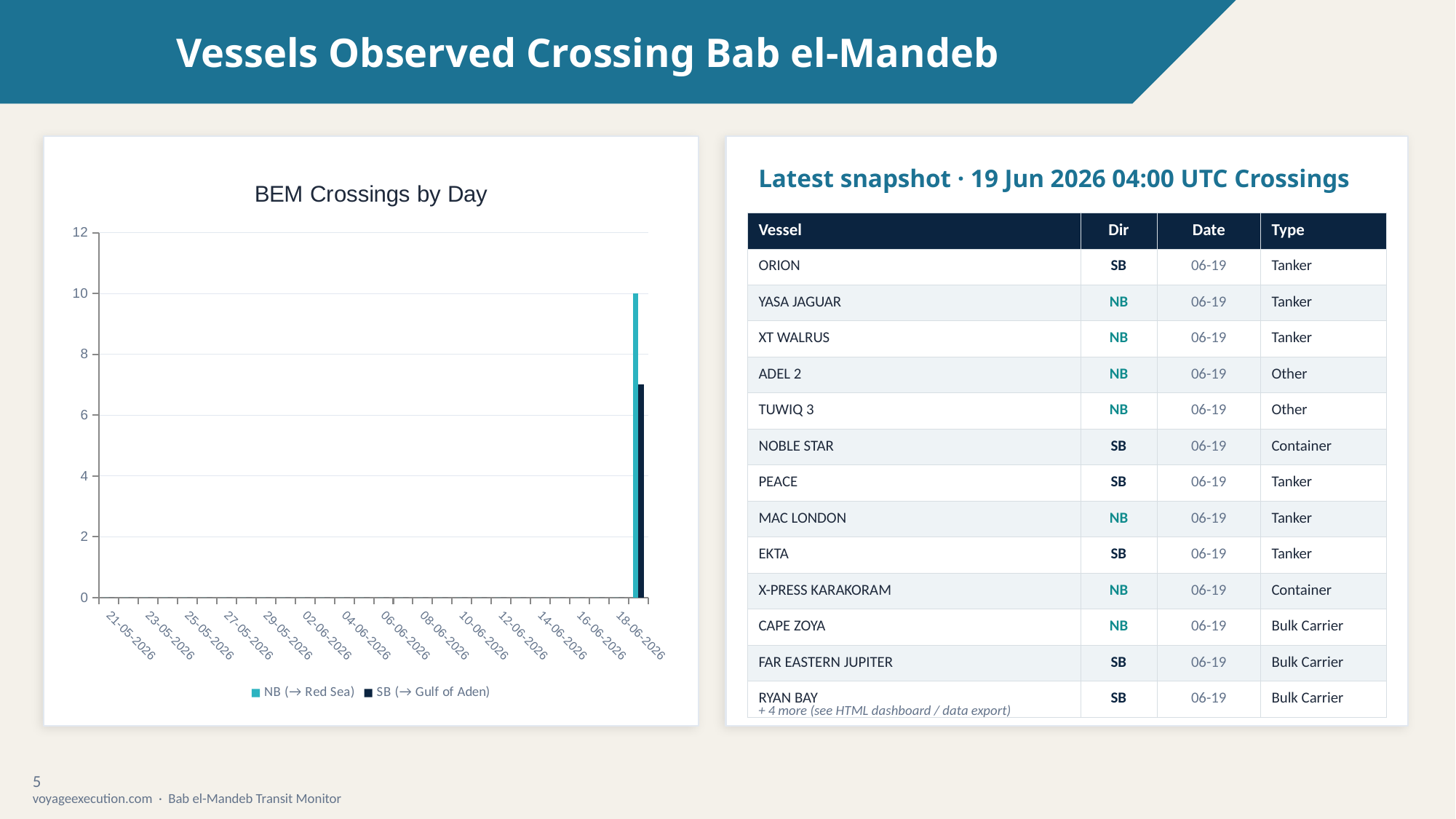
What kind of chart is "BEM Crossings by Day"? bar chart How many series does the legend of "BEM Crossings by Day" list? 2 In "BEM Crossings by Day", which series reaches the highest value on the chart? NB (→ Red Sea) In "BEM Crossings by Day", which series is shown in the lighter teal colour? NB (→ Red Sea) What is the title of the chart on the left of the slide? BEM Crossings by Day